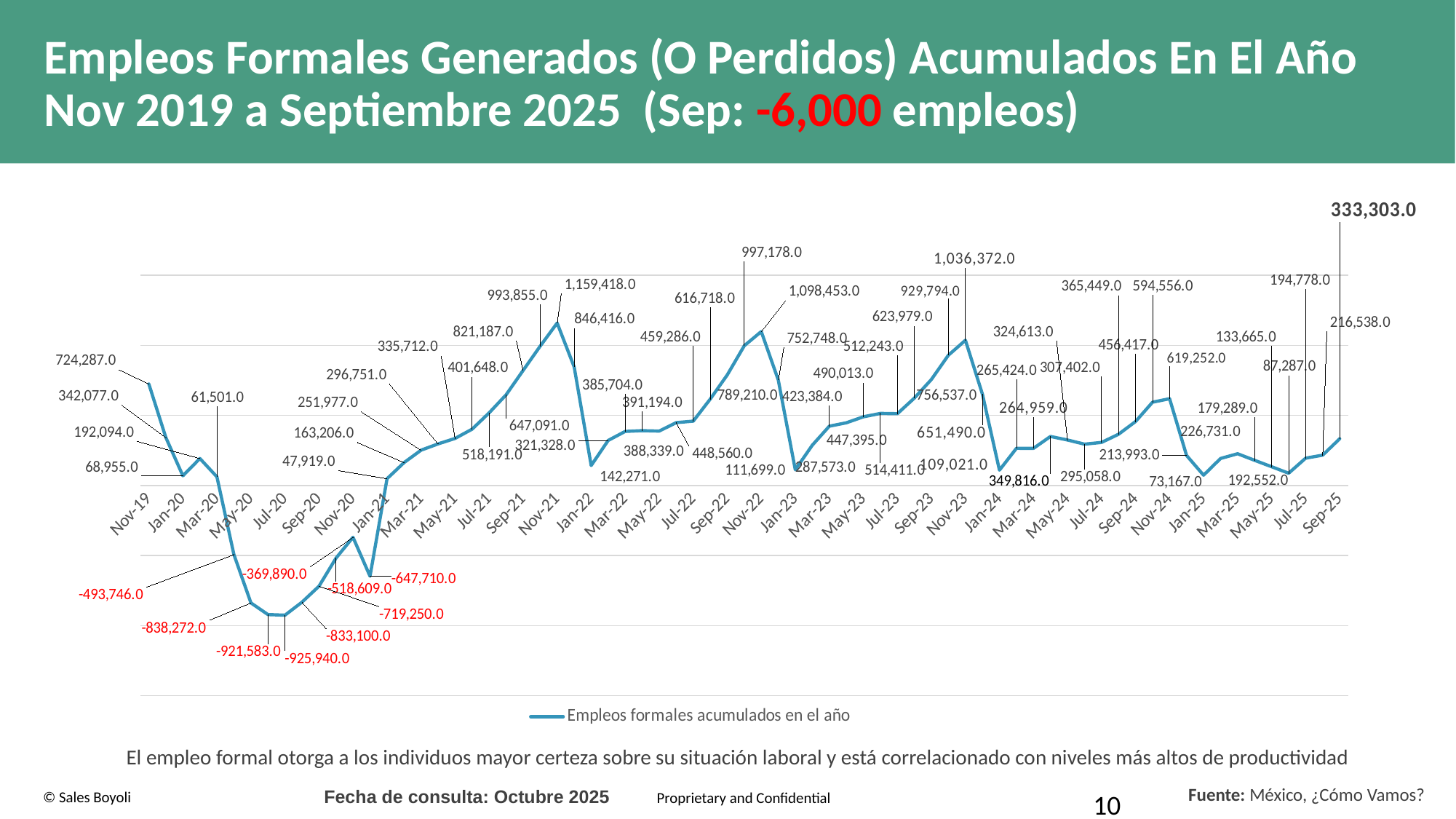
What is the lowest value plotted on the chart? -925,940.0 How many series does the legend list? 1 What is the highest value plotted on the chart? 1,159,418.0 What is the name of the series shown in the legend? Empleos formales acumulados en el año What kind of chart is shown on the slide? Line chart How many data labels are shown in red (negative values) on the chart? 9 What is the value for Nov-19, the first point on the chart? 724,287.0 What is the difference between the highest value (1,159,418.0) and the lowest value (-925,940.0) on the chart? 2,085,358.0 Does the line rise or fall between Nov-21 and Jan-22? Fall What is the difference between the Nov-21 peak (1,159,418.0) and the Nov-22 peak (1,098,453.0)? 60,965.0 Which is larger: the peak at Nov-21 or the peak at Nov-23? Nov-21 What is the value for Sep-25, the last point on the chart? 333,303.0